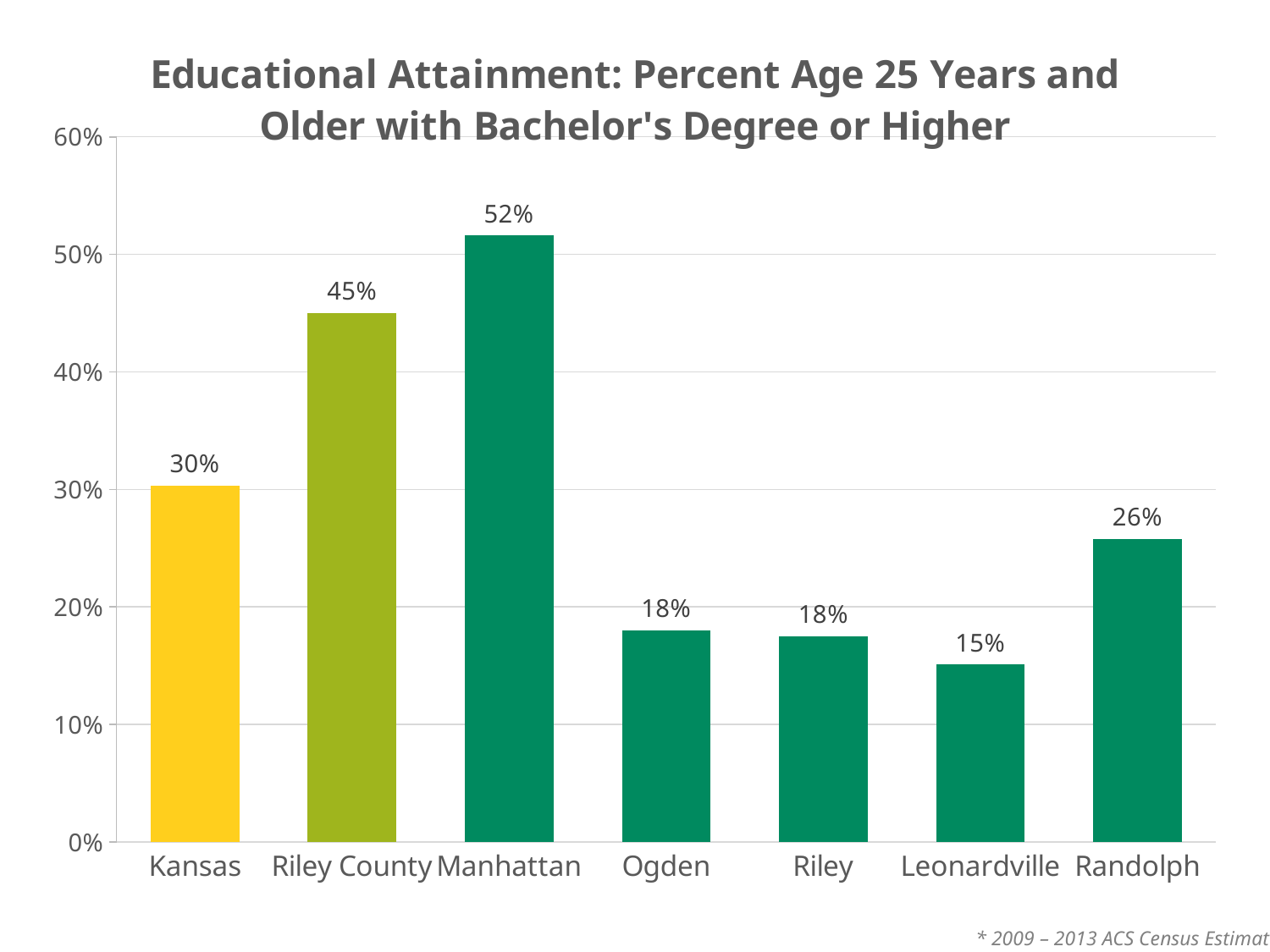
What colour is the bar for Kansas? yellow Is the value for Riley County greater or less than 40%? greater What kind of chart is shown on the slide? bar chart Which category has the highest value? Manhattan Which is larger, the value for Kansas or the value for Randolph? Kansas How many categories are shown on the x axis? 7 What is the value for Manhattan? 52% What is the value for Kansas? 30% What is the value for Leonardville? 15% Which category has the lowest value? Leonardville What is the difference between the values for Manhattan and Riley County? 7% What is the value for Randolph? 26%